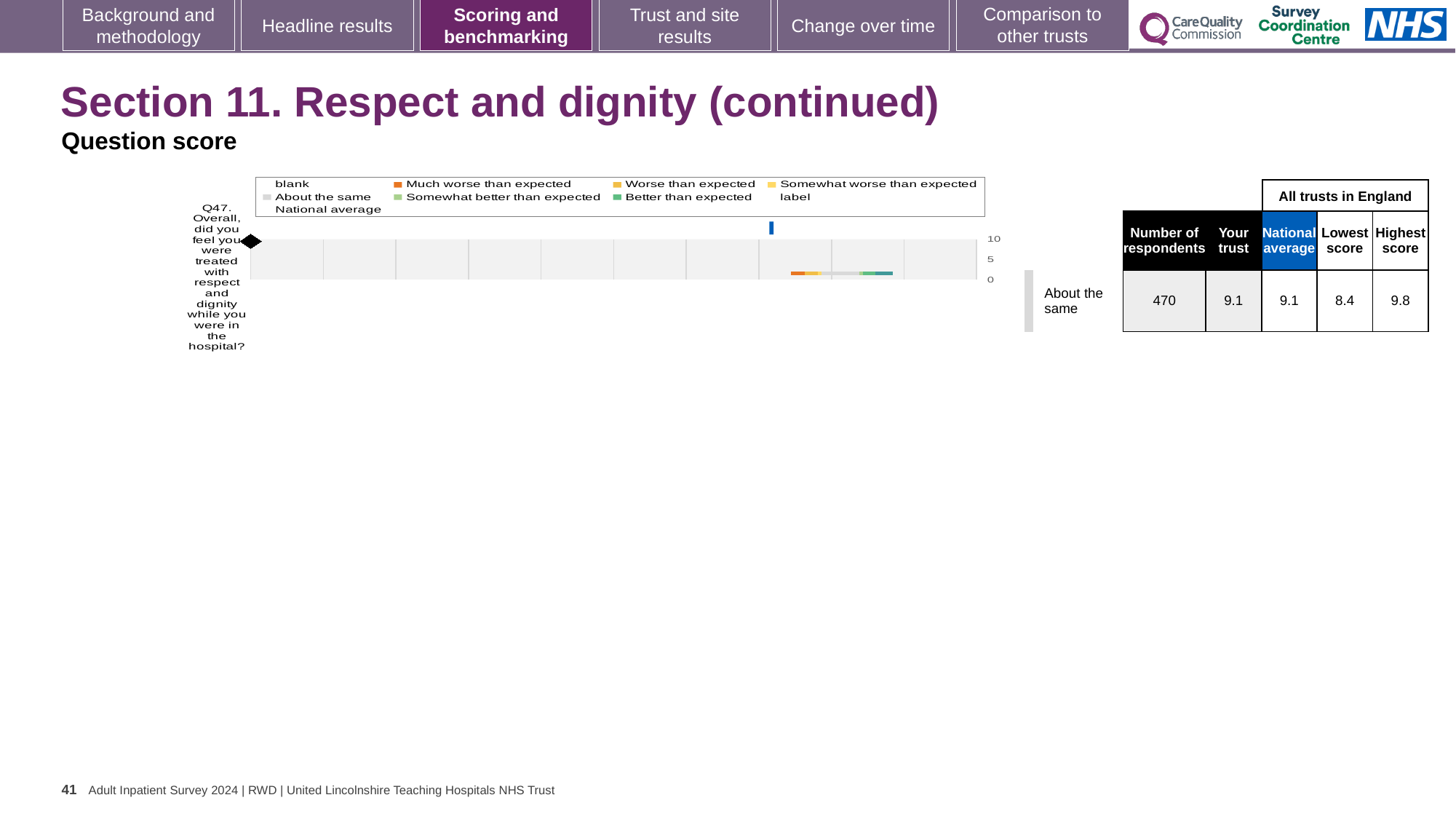
How many questions are plotted on the chart? 1 What is the 'Your trust' score for Q47 (treated with respect and dignity while in hospital)? 9.1 Which is larger for Q47: the lowest score or the highest score among all trusts in England? Highest score Is the trust's score for Q47 greater or less than 5 on the chart axis? greater What kind of chart is shown on the slide? Bar chart What is the lowest score among all trusts in England for Q47? 8.4 Which benchmark category is Q47 placed in? About the same How much higher is the highest score in England than this trust's score for Q47? 0.7 How many respondents answered Q47? 470 What is the difference between the highest and lowest trust scores for Q47? 1.4 What is the national average score for Q47? 9.1 What is the highest score among all trusts in England for Q47? 9.8